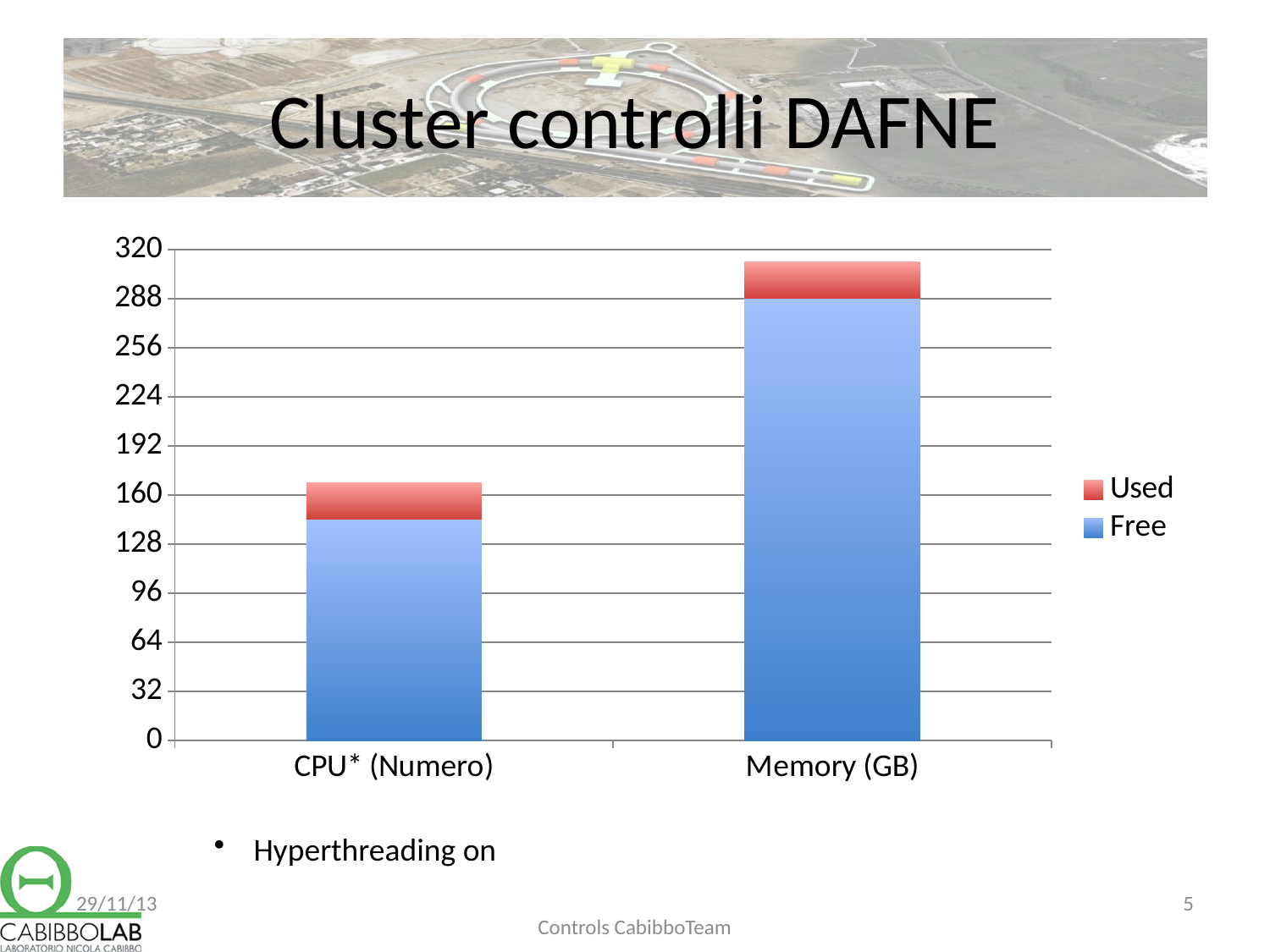
Which category has the highest total bar? Memory (GB) Which category has the taller stacked bar, CPU* (Numero) or Memory (GB)? Memory (GB) Which category has the lowest total bar? CPU* (Numero) Is the total value for Memory (GB) greater or less than 320? less How many categories are shown on the x axis of the chart? 2 Is the Free value for CPU* (Numero) greater or less than 128? greater Is the total value for CPU* (Numero) greater or less than 160? greater Which colour represents the Used series in the chart? red How many series does the chart's legend list? 2 What kind of chart is shown on the slide? bar chart What are the two series named in the chart's legend? Used and Free